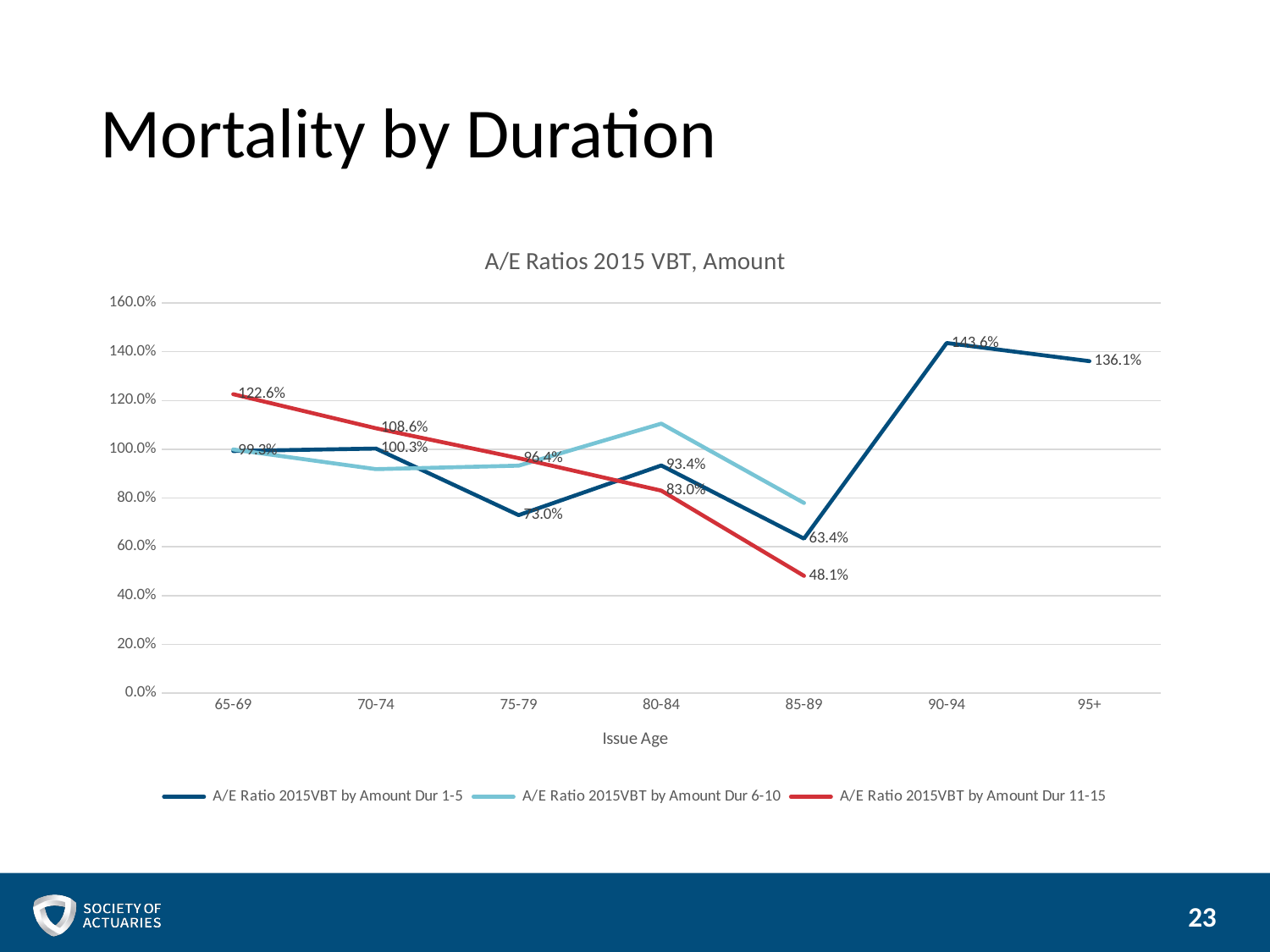
What is the A/E Ratio 2015VBT by Amount Dur 1-5 for issue age 90-94? 143.6% What is the difference between the Dur 1-5 A/E ratio at issue age 90-94 and at 95+? 7.5 percentage points What kind of chart is shown on the slide? Line chart For which issue age group is the Dur 1-5 A/E ratio highest? 90-94 What is the A/E Ratio 2015VBT by Amount Dur 11-15 for issue age 65-69? 122.6% At issue age 85-89, which is larger: the Dur 1-5 A/E ratio or the Dur 11-15 A/E ratio? Dur 1-5 For which issue age group is the Dur 11-15 A/E ratio lowest? 85-89 Is the Dur 6-10 A/E ratio at issue age 80-84 greater or less than 100.0%? greater What is the A/E Ratio 2015VBT by Amount Dur 11-15 for issue age 85-89? 48.1% What is the A/E Ratio 2015VBT by Amount Dur 1-5 for issue age 95+? 136.1% How many series does the legend list? 3 How many issue age groups are shown on the x axis? 7